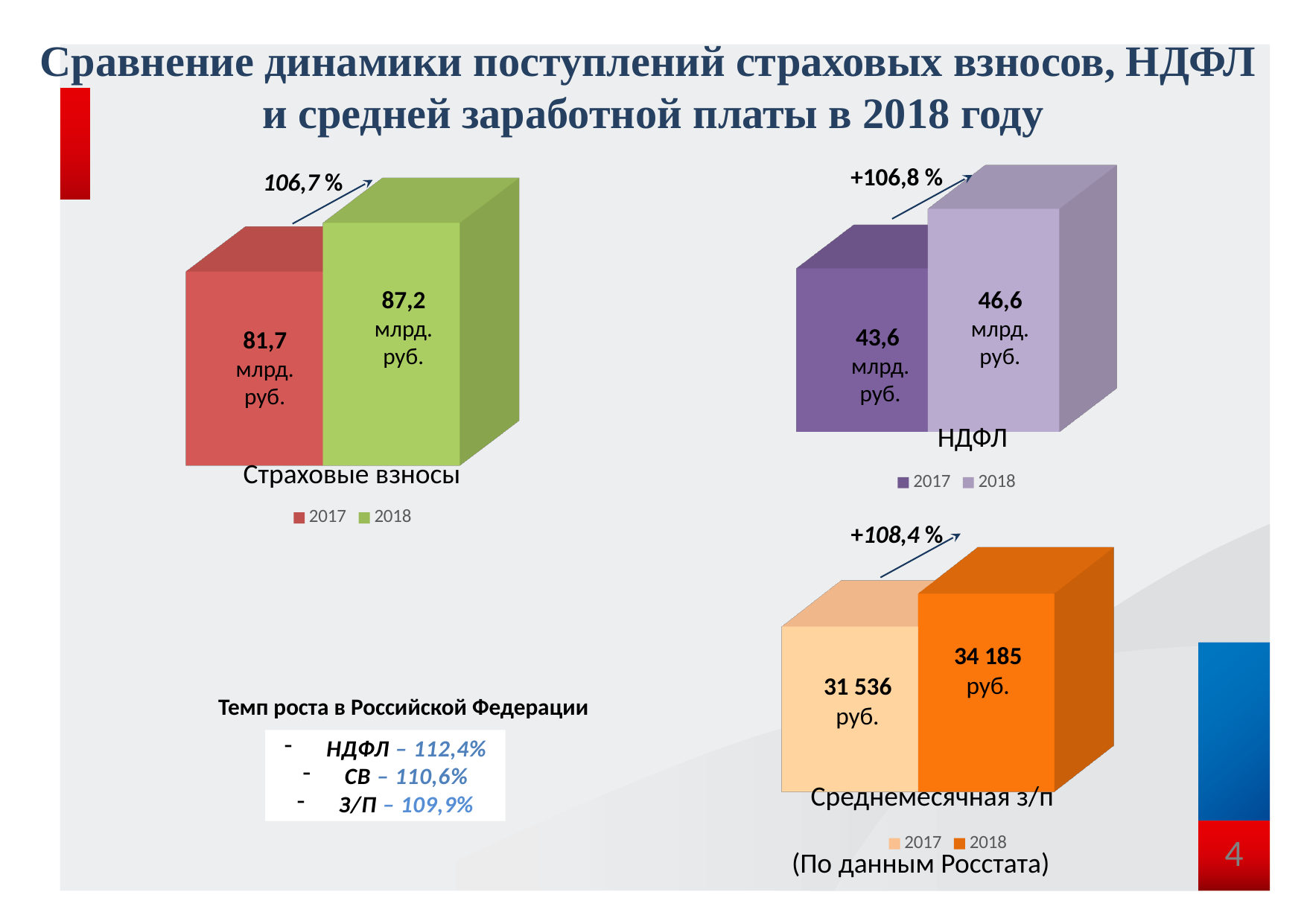
In the chart titled 'НДФЛ', what is the value for 2018? 46,6 млрд. руб. What kind of chart is the chart titled 'Среднемесячная з/п'? Bar chart In the chart titled 'Среднемесячная з/п', what is the value for 2018? 34 185 руб. In the chart titled 'НДФЛ', what is the difference between the 2018 and 2017 values? 3,0 млрд. руб. In the chart titled 'Страховые взносы', what is the value for 2017? 81,7 млрд. руб. In the chart titled 'Страховые взносы', what is the difference between the 2018 and 2017 values? 5,5 млрд. руб. How many series does the legend of the chart titled 'Страховые взносы' list? 2 What growth percentage is annotated above the chart titled 'Среднемесячная з/п'? +108,4 % In the chart titled 'НДФЛ', which year has the higher value, 2017 or 2018? 2018 In the chart titled 'Среднемесячная з/п', what is the difference between the 2018 and 2017 values? 2 649 руб. In the chart titled 'Страховые взносы', what is the value for 2018? 87,2 млрд. руб. In the chart titled 'Среднемесячная з/п', what is the value for 2017? 31 536 руб.